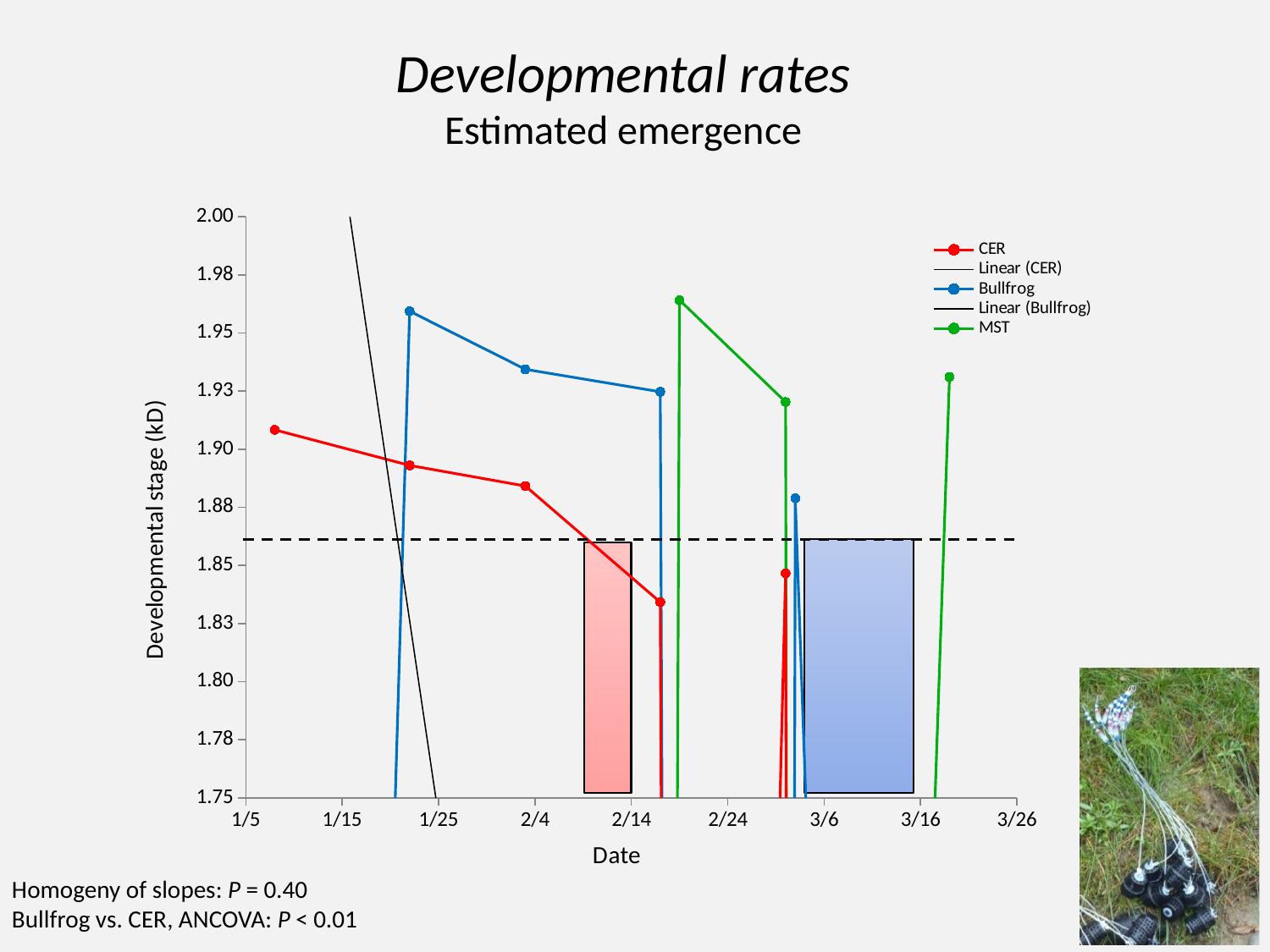
Is the first Bullfrog point (around 1/22) greater or less than 1.95? greater Which series is plotted in green? MST How many data points are plotted for the MST series? 3 Is the CER point around 2/17 greater or less than 1.85? less What is the label of the y axis? Developmental stage (kD) Is the CER point around 2/3 greater or less than 1.90? less Which is higher, the first Bullfrog point (around 1/22) or the first CER point (around 1/8)? Bullfrog What kind of chart is shown on the slide? line chart Do the CER values rise or fall from 1/8 to 2/17? fall How many series does the legend list? 5